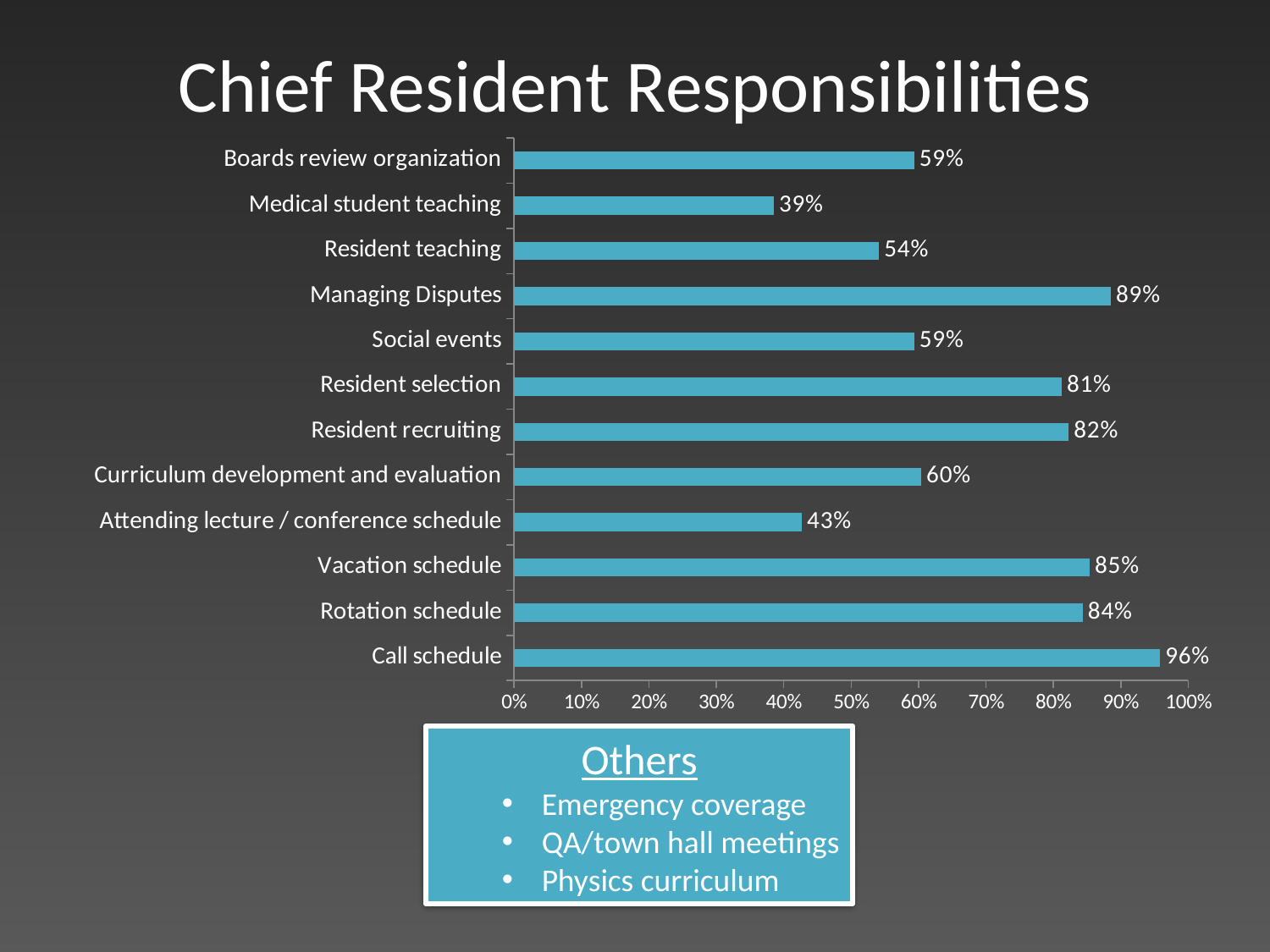
What is the difference between the values for Call schedule and Medical student teaching? 57% What is the value for Managing Disputes? 89% What is the value for Medical student teaching? 39% How many categories are shown in the chart? 12 What is the value for Call schedule? 96% What kind of chart is shown on the slide? bar chart Which is larger, the value for Resident recruiting or the value for Resident selection? Resident recruiting Which category has the lowest value? Medical student teaching Which category has the highest value? Call schedule What is the difference between the values for Vacation schedule and Rotation schedule? 1% What is the title of the chart? Chief Resident Responsibilities Is the value for Attending lecture / conference schedule greater or less than 50%? less